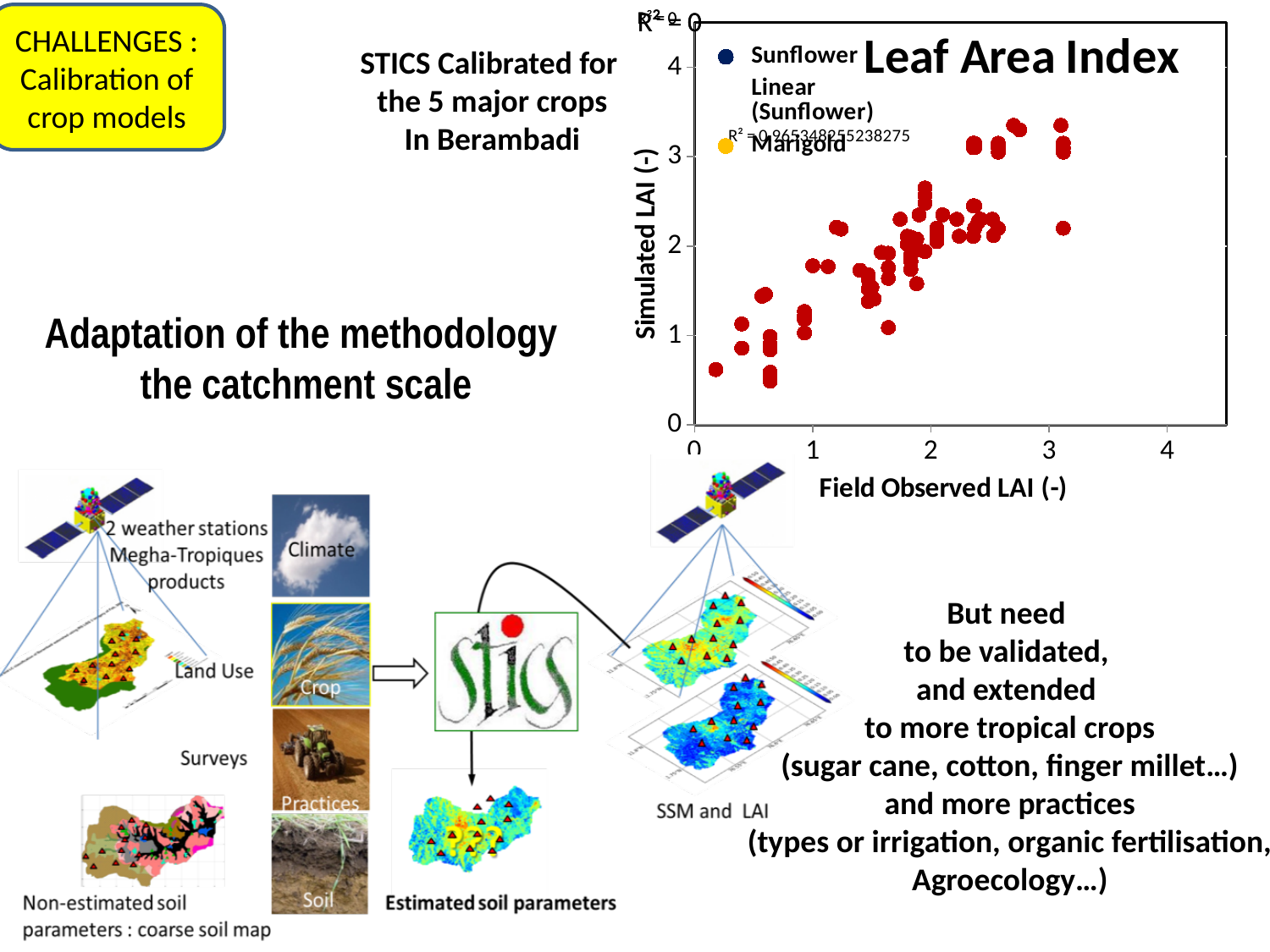
What is the title of the chart on the slide? Leaf Area Index In the "Leaf Area Index" chart, do the simulated LAI values generally rise or fall as the field observed LAI increases? rise In the "Leaf Area Index" chart, is the lowest simulated LAI value plotted greater or less than 1? less What is the highest tick value shown on the y axis of the "Leaf Area Index" chart? 4 What is the label of the x axis of the "Leaf Area Index" chart? Field Observed LAI (-) In the "Leaf Area Index" chart, is the largest field observed LAI value plotted greater or less than 4? less What kind of chart is the "Leaf Area Index" chart? scatter chart In the "Leaf Area Index" chart, is the highest simulated LAI value plotted greater or less than 3? greater